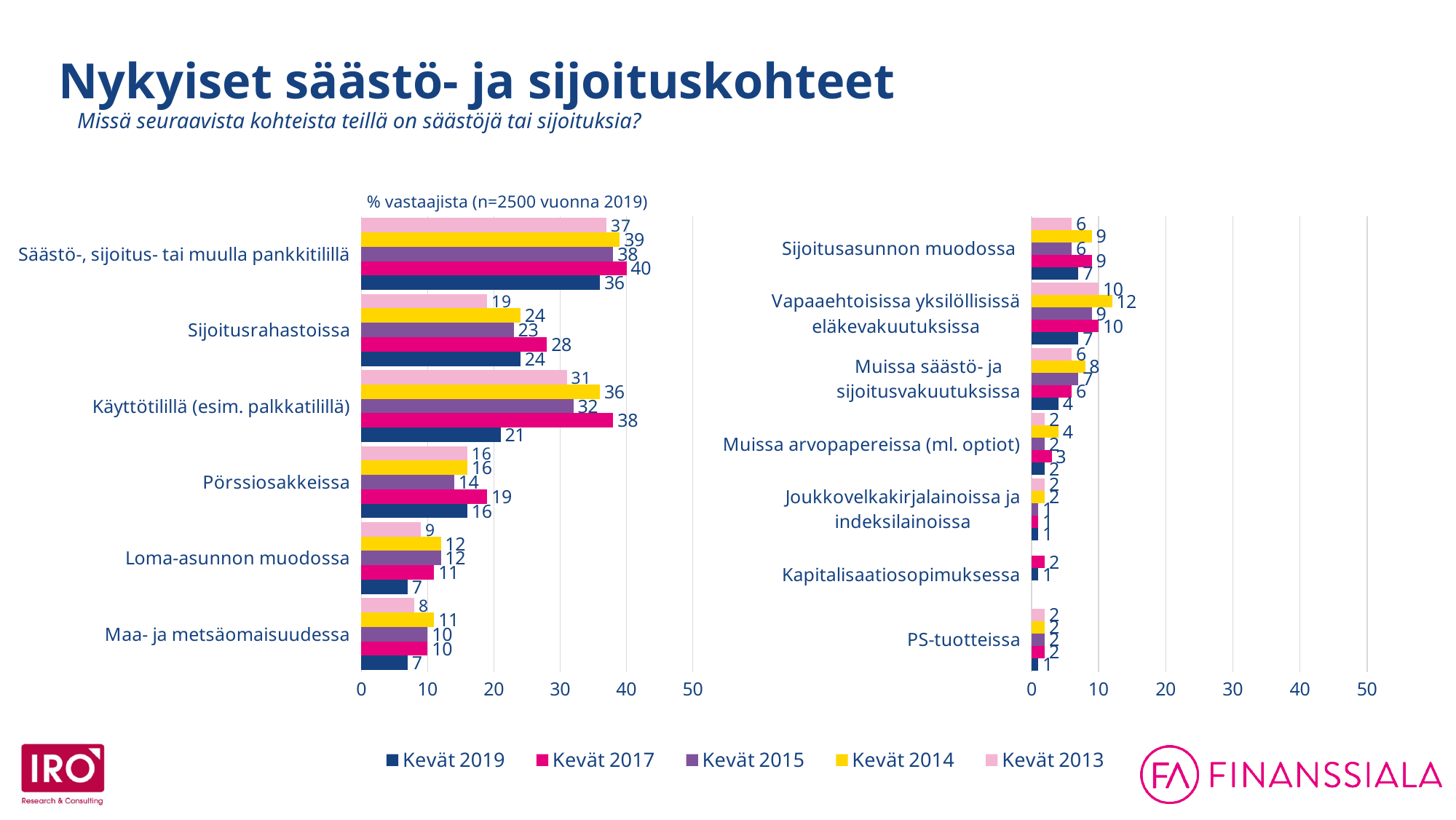
What kind of chart is the left chart? Bar chart How many series does the legend list? 5 In the right chart, which is larger for Sijoitusasunnon muodossa: the Kevät 2017 value or the Kevät 2019 value? Kevät 2017 In the left chart, what is the difference between the Kevät 2017 and Kevät 2019 values for Käyttötilillä (esim. palkkatilillä)? 17 In the left chart, which series has the lowest value for Käyttötilillä (esim. palkkatilillä)? Kevät 2019 In the right chart, what is the Kevät 2019 value for Muissa säästö- ja sijoitusvakuutuksissa? 4 Which legend entry is shown in yellow? Kevät 2014 In the left chart, which series has the highest value for Sijoitusrahastoissa? Kevät 2017 In the right chart, what is the Kevät 2014 value for Vapaaehtoisissa yksilöllisissä eläkevakuutuksissa? 12 How many categories are shown in the right chart? 7 In the left chart, what is the Kevät 2019 value for Säästö-, sijoitus- tai muulla pankkitilillä? 36 In the left chart, what is the Kevät 2017 value for Käyttötilillä (esim. palkkatilillä)? 38